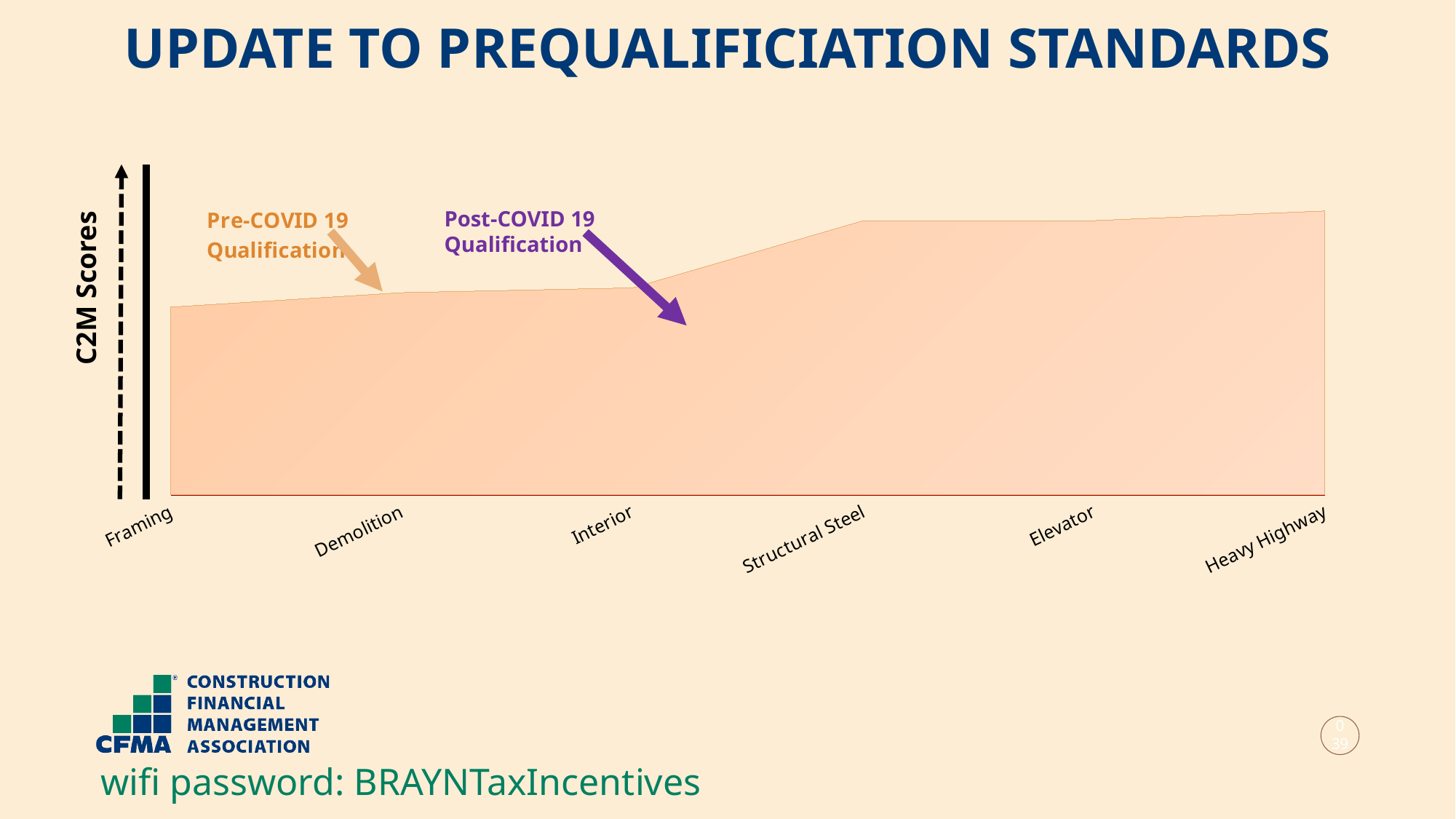
Which has the larger C2M score, Framing or Structural Steel? Structural Steel Which has the larger C2M score, Demolition or Elevator? Elevator Which category comes immediately after Interior on the x axis? Structural Steel Which category has the lowest C2M score in the chart? Framing What kind of chart is shown on the slide? Area chart Do the C2M scores generally rise or fall moving from Framing to Heavy Highway along the x axis? Rise What is the first category on the x axis of the chart? Framing What is the label on the vertical axis of the chart? C2M Scores Which has the larger C2M score, Interior or Heavy Highway? Heavy Highway How many categories are shown along the x axis of the chart? 6